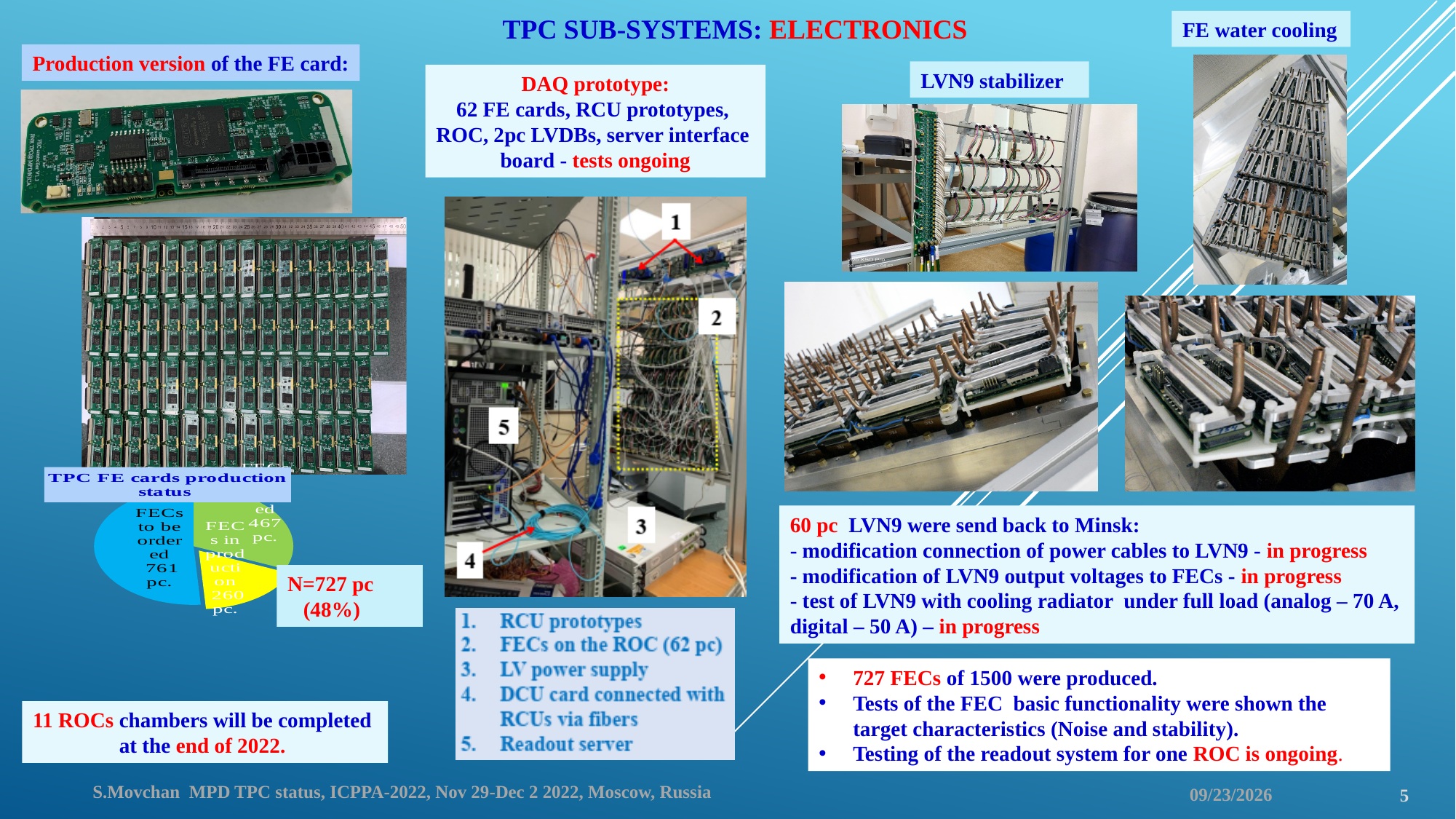
What is the title of the pie chart on the slide? TPC FE cards production status In the 'TPC FE cards production status' pie chart, which slice has the smallest value? FECs in production In the 'TPC FE cards production status' pie chart, what is the difference between the FECs to be ordered (761) and the green slice (467)? 294 pc. In the 'TPC FE cards production status' pie chart, which is larger: the green slice or the FECs in production slice? the green slice (467 pc.) In the 'TPC FE cards production status' pie chart, how many FECs are in production? 260 pc. In the 'TPC FE cards production status' pie chart, how many FECs are to be ordered? 761 pc. In the 'TPC FE cards production status' pie chart, what is the difference between the FECs to be ordered and the FECs in production? 501 pc. How many slices does the 'TPC FE cards production status' pie chart have? 3 What kind of chart is the 'TPC FE cards production status' chart? pie chart In the 'TPC FE cards production status' pie chart, what value is shown on the green slice? 467 pc. In the 'TPC FE cards production status' pie chart, which slice has the largest value? FECs to be ordered In the 'TPC FE cards production status' pie chart, what colour is the 'FECs to be ordered' slice? blue